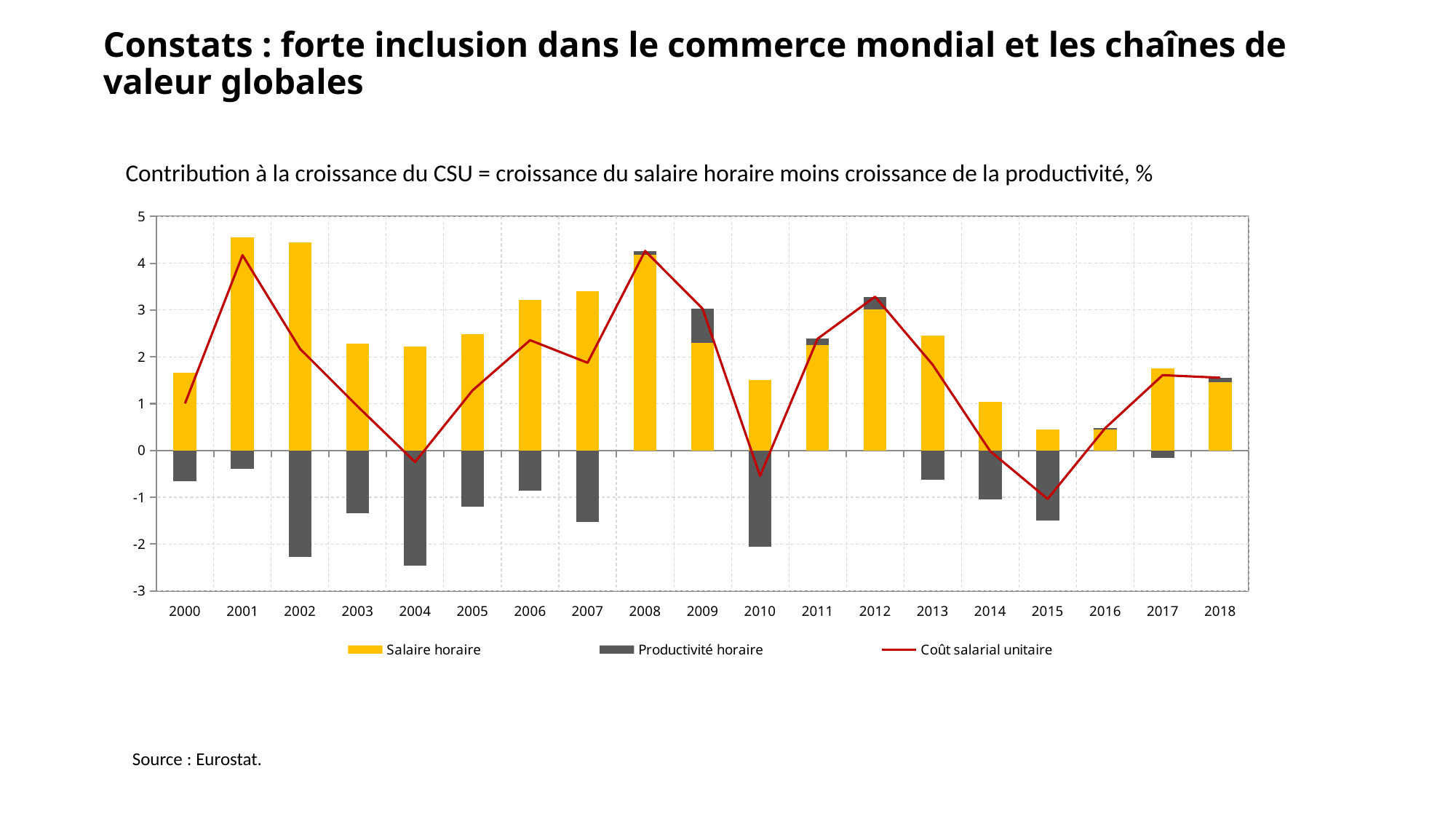
Is the Productivité horaire value for 2004 greater or less than -2? less Is the Salaire horaire value for 2015 greater or less than 1? less Which is larger, the Salaire horaire value for 2007 or for 2010? 2007 How many series does the legend list? 3 How many years are shown on the x axis? 19 Which year has the lowest Coût salarial unitaire value? 2015 Does the Coût salarial unitaire line rise or fall from 2012 to 2015? fall Is the Salaire horaire value for 2001 greater or less than 4? greater What colour are the Salaire horaire bars? Yellow What kind of chart is shown on the slide? A combined bar and line chart